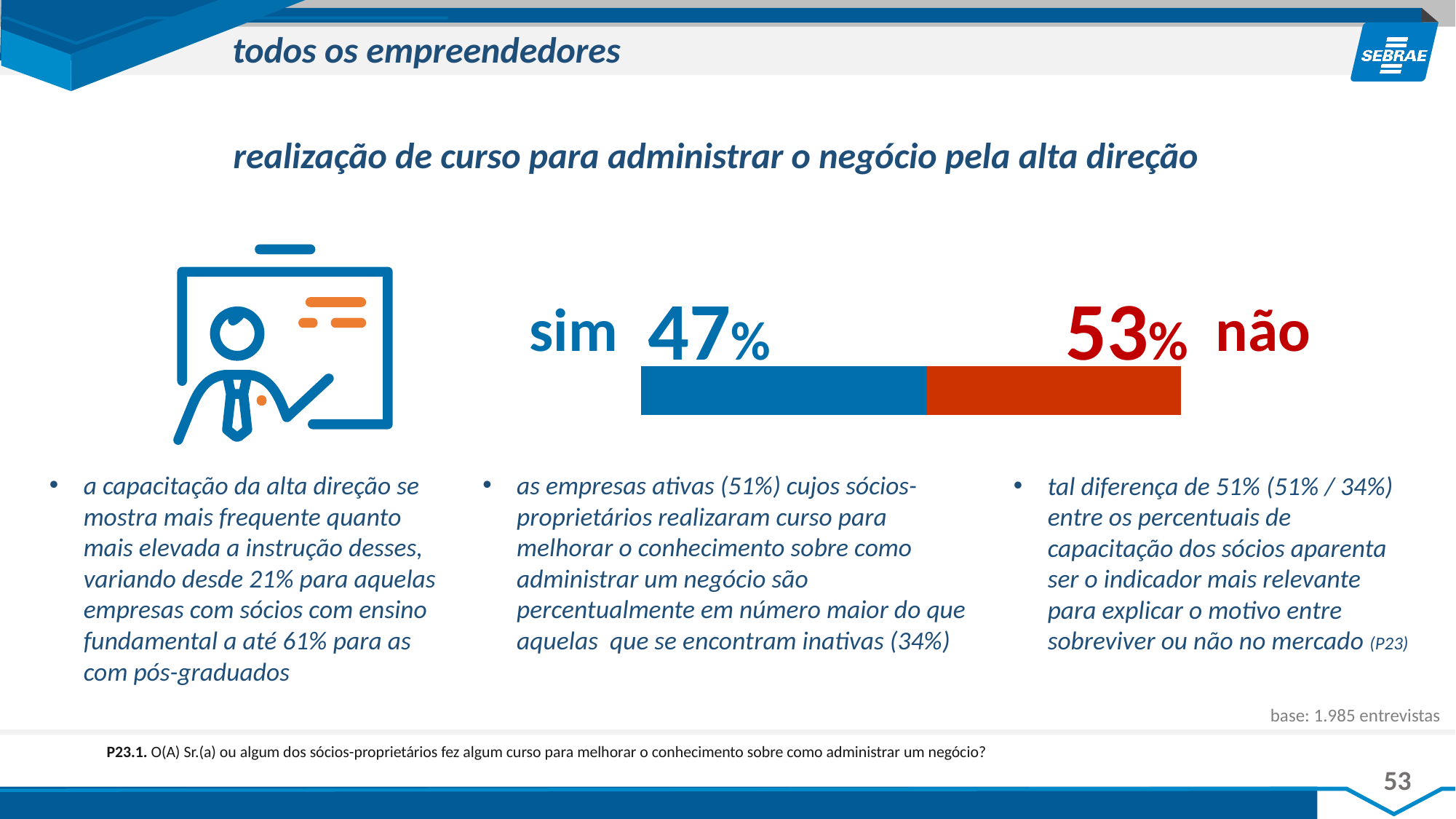
What is the value for "não" in the bar chart? 53% How many categories are shown in the bar chart? 2 Which category has the highest value in the bar chart? não What kind of chart is shown on the slide? bar chart What is the difference between the "não" and "sim" values? 6% Is the value for "sim" greater or less than 50%? less What is the value for "sim" in the bar chart? 47% Which category has the higher value, "sim" or "não"? não What is the total of the two segments of the stacked bar? 100% Which category has the lowest value in the bar chart? sim What is the title of the chart on the slide? realização de curso para administrar o negócio pela alta direção What colour is the "não" segment of the bar? red